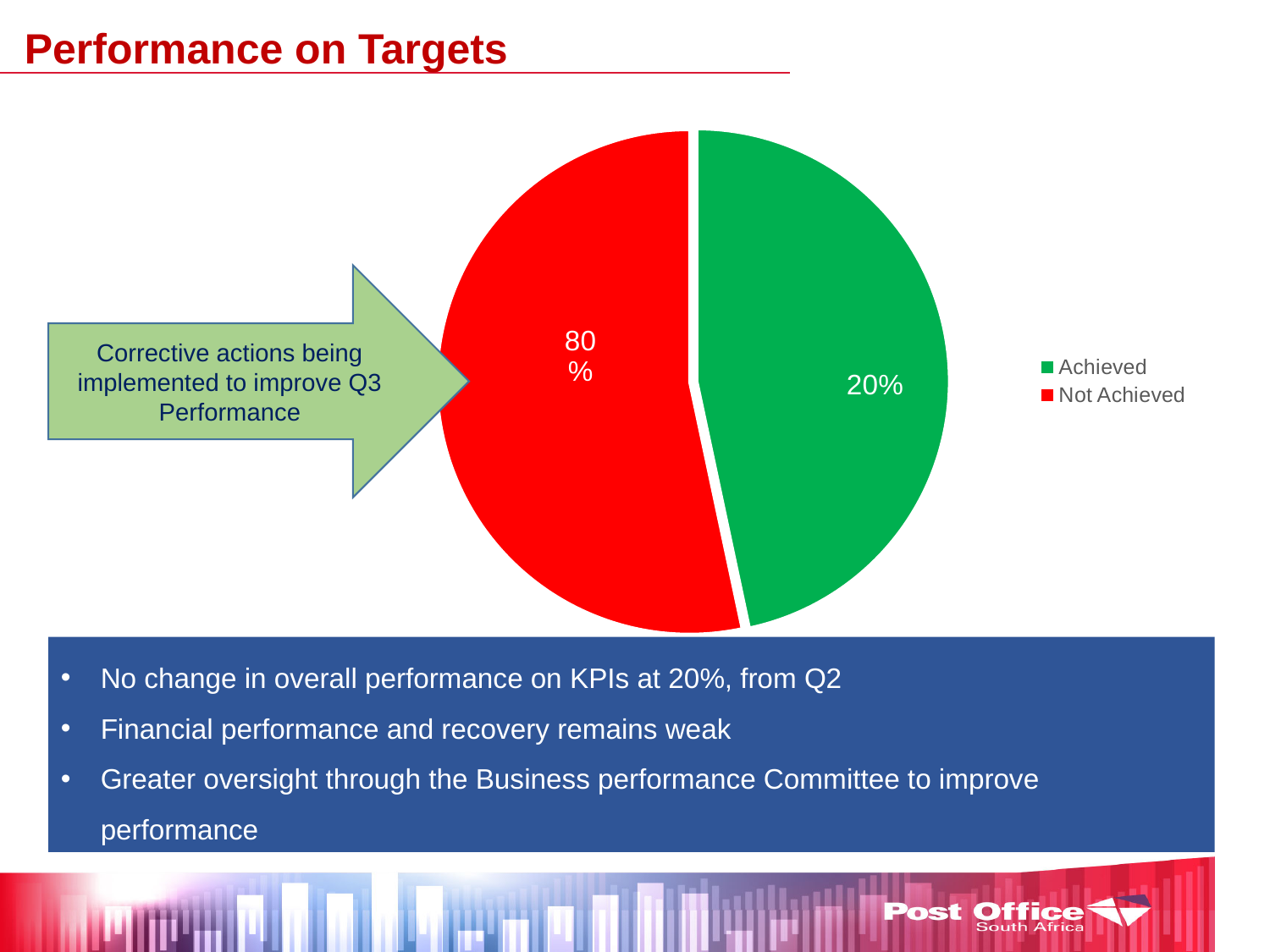
Which slice of the pie is the smallest? Achieved How many entries does the legend list? 2 What colour is used for the Not Achieved slice? red Which is larger, the Achieved slice or the Not Achieved slice? Not Achieved What percentage of the pie is labelled for the Achieved slice? 20% What percentage of the pie is labelled for the Not Achieved slice? 80% What type of chart is shown on the slide? pie chart What colour is used for the Achieved slice? green How many slices does the pie chart have? 2 Which slice of the pie is the largest? Not Achieved